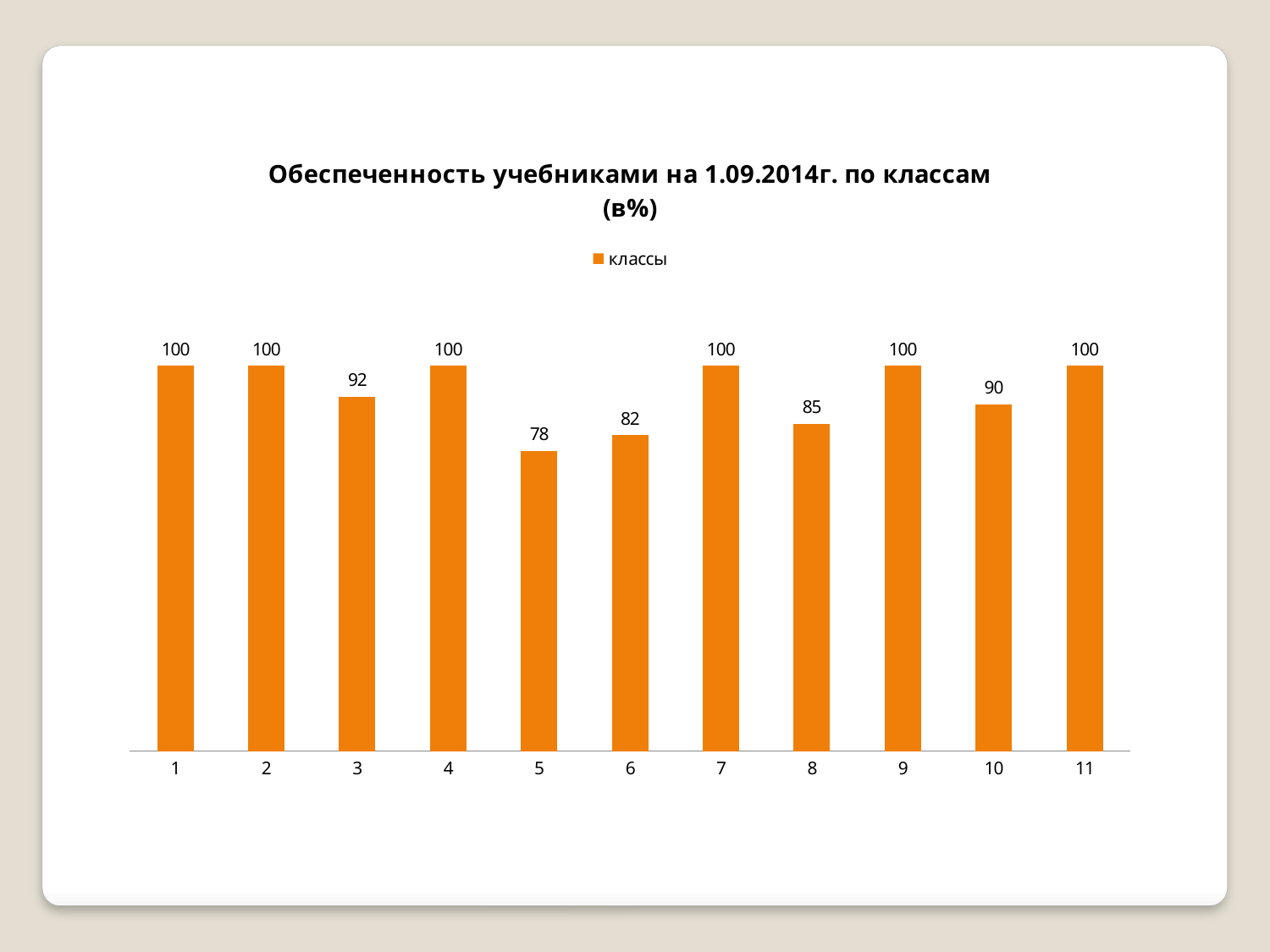
What is the value for class 3? 92 What is the value for class 5? 78 Which class has the lowest value? 5 What is the difference between the values for class 10 and class 6? 8 What is the value for class 10? 90 What is the legend entry of the chart? классы How many series does the legend list? 1 What is the value for class 8? 85 What kind of chart is shown on the slide? bar chart What is the difference between the values for class 3 and class 5? 14 How many classes are shown on the x axis? 11 Which is larger, the value for class 6 or the value for class 8? class 8